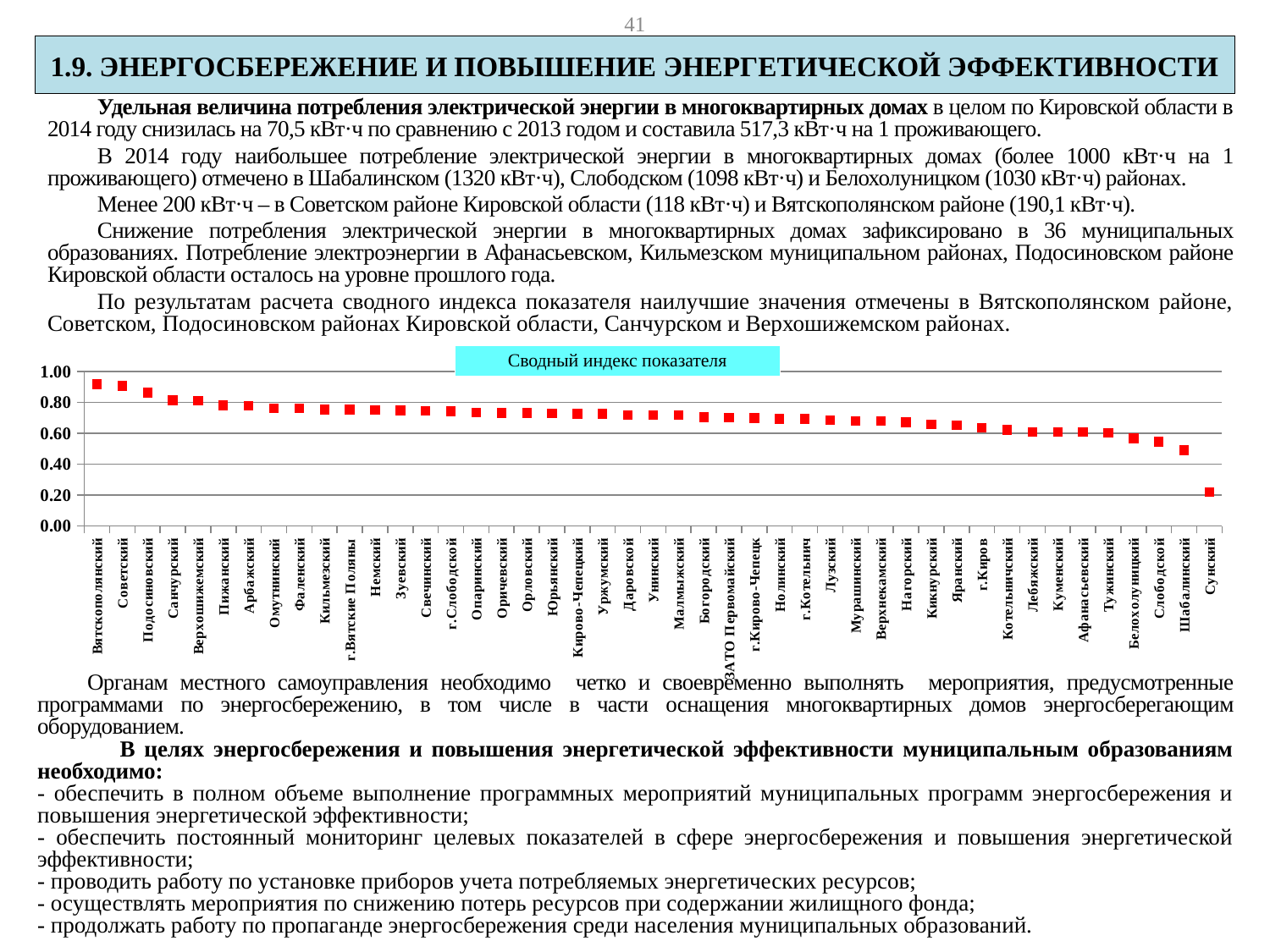
Is the value for Немский greater or less than 0.60? greater Which category has the highest value in the chart? Вятскополянский Which has the larger value, Советский or Шабалинский? Советский Is the value for Шабалинский greater or less than 0.60? less Is the value for Вятскополянский greater or less than 0.80? greater How many categories are plotted on the x axis of the chart? 45 Which category has the lowest value in the chart? Сунский Do the values rise or fall moving from left to right along the x axis? fall What is the title of the chart? Сводный индекс показателя What kind of chart is shown on the slide? scatter chart